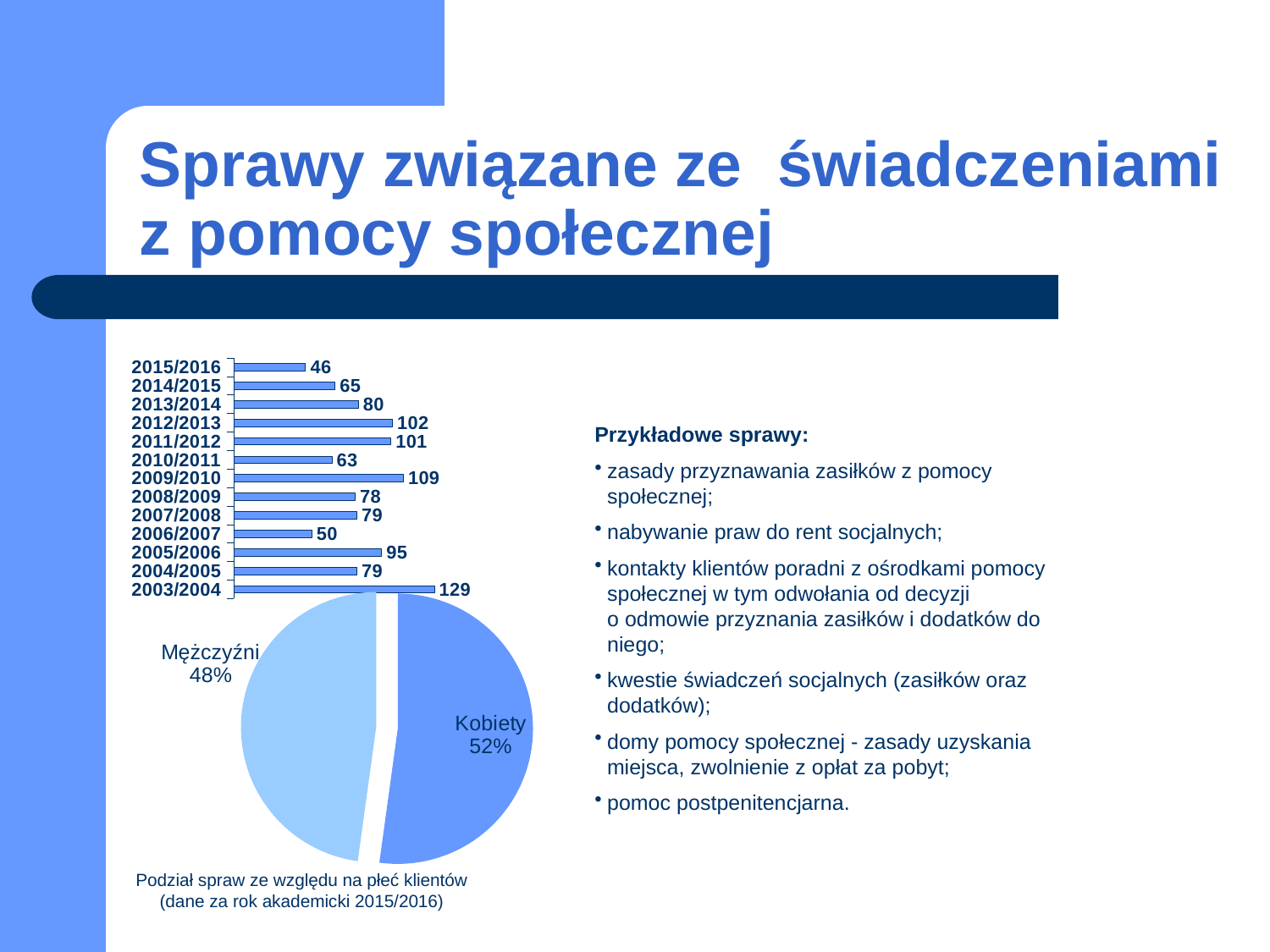
What kind of chart is the chart at the bottom left of the slide? pie chart In the bar chart, which is larger, the value for 2005/2006 or the value for 2013/2014? 2005/2006 In the bar chart, what is the value for 2009/2010? 109 In the bar chart, what is the difference between the values for 2012/2013 and 2010/2011? 39 How many academic years are shown in the bar chart? 13 In the bar chart, what is the value for 2015/2016? 46 In the bar chart, what is the value for 2003/2004? 129 In the bar chart, which academic year has the highest value? 2003/2004 In the pie chart, what share is labelled Kobiety? 52% What kind of chart is the chart at the top left of the slide? bar chart In the pie chart, what share is labelled Mężczyźni? 48% In the bar chart, which academic year has the lowest value? 2015/2016